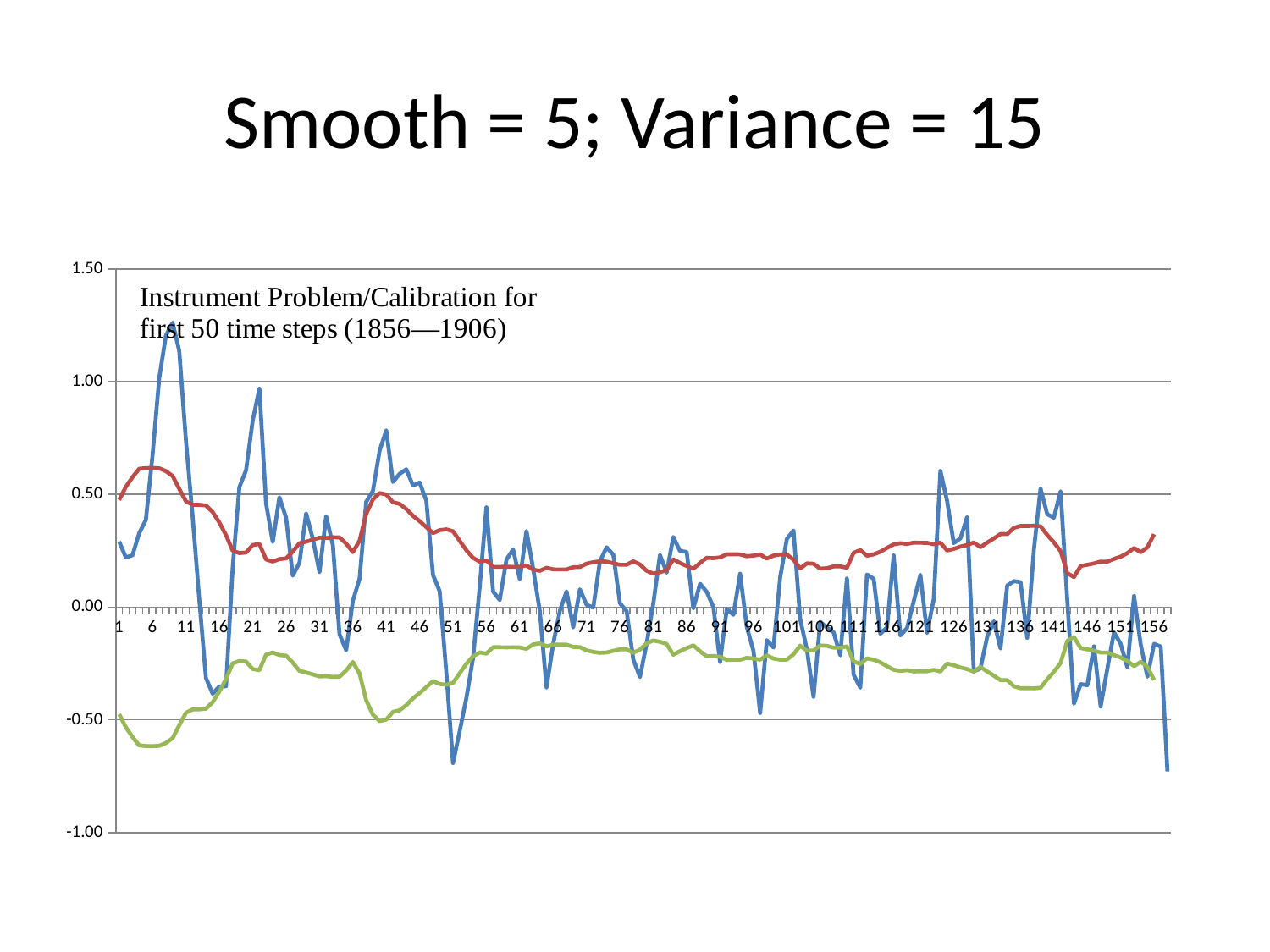
Is the value of the green line at time step 6 greater or less than -0.50? less What is the highest value shown on the y axis? 1.50 Is the peak of the blue line near time step 9 greater or less than 1.00? greater Is the value of the blue line at time step 156 greater or less than -0.50? greater Which line reaches the highest value anywhere on the chart? the blue line At time step 9, which is larger, the blue line or the red line? the blue line Does the red line overall rise or fall between time step 1 and time step 156? fall What does the text annotation inside the chart say? Instrument Problem/Calibration for first 50 time steps (1856—1906) What kind of chart is shown on the slide? line chart How many lines are plotted on the chart? 3 What is the title of the slide? Smooth = 5; Variance = 15